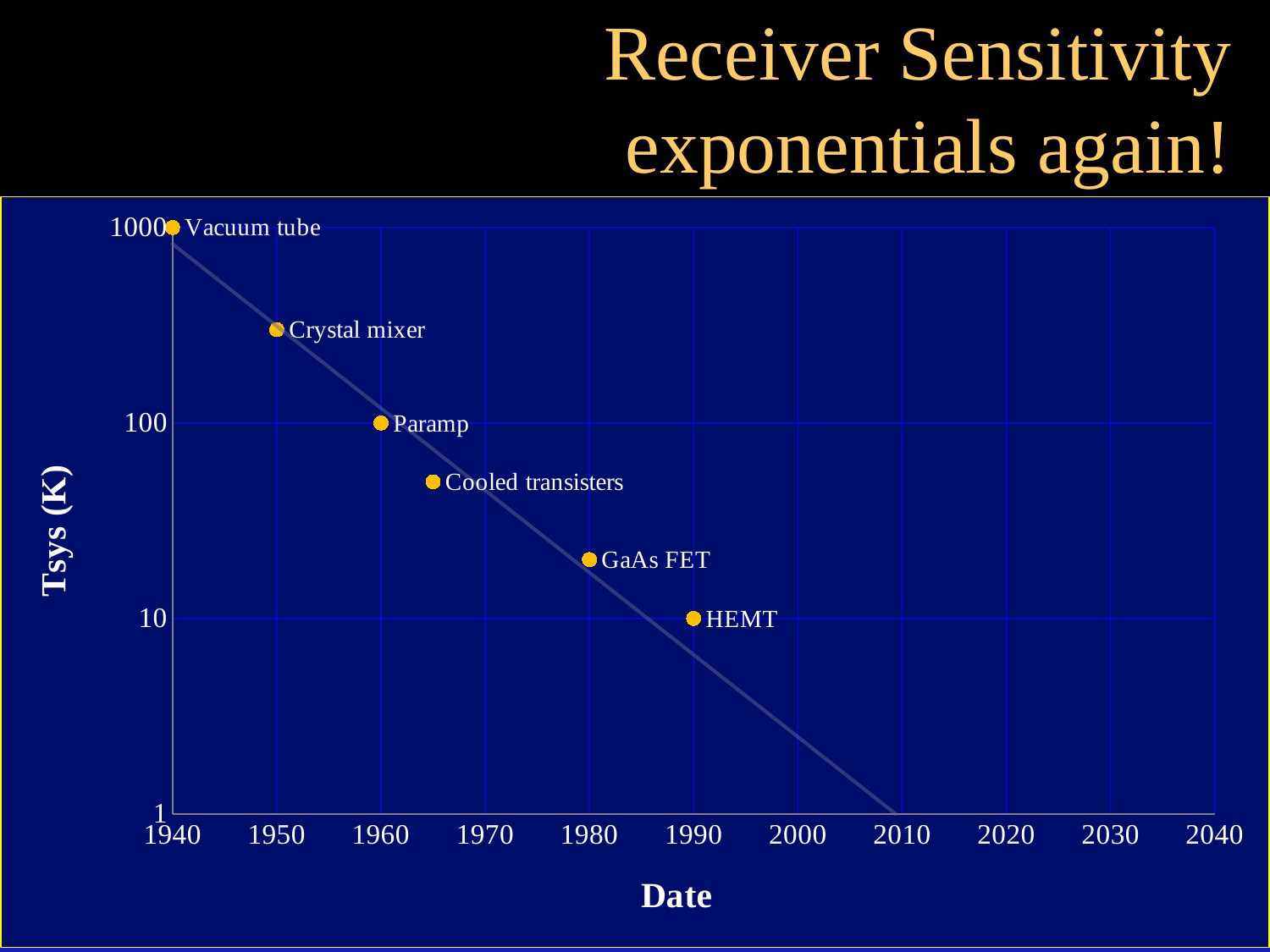
Do the Tsys values rise or fall as the date increases? fall Which receiver technology has the lowest Tsys (K)? HEMT What is the Tsys (K) value for HEMT? 10 How many data points are plotted on the chart? 6 What kind of chart is shown on the slide? scatter chart What is the Tsys (K) value for Vacuum tube? 1000 Which receiver technology has the highest Tsys (K)? Vacuum tube Is the Tsys value for Cooled transisters greater or less than 100? less Is the Tsys value for Crystal mixer greater or less than 100? greater In what year is the HEMT point plotted? 1990 What is the difference in Tsys (K) between Vacuum tube and Paramp? 900 What is the Tsys (K) value for Paramp? 100